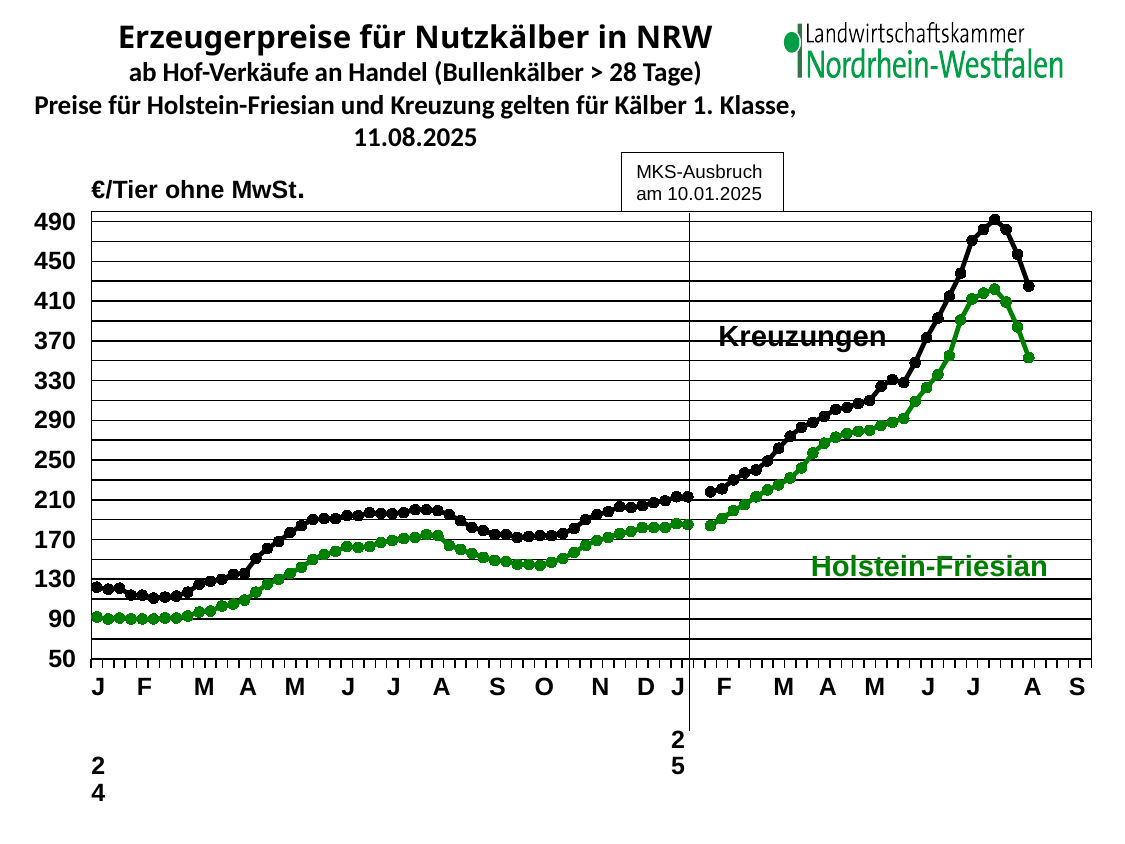
What unit is given for the vertical axis? €/Tier ohne MwSt. In which year does the Kreuzungen line reach its highest value? 2025 What kind of chart is shown on the slide? line chart Is the Holstein-Friesian value in January 2024 greater or less than 130? less Is the highest value of the Holstein-Friesian line greater or less than 370? greater Is the Kreuzungen value in January 2024 greater or less than 170? less Which series has the higher values throughout the chart, Kreuzungen or Holstein-Friesian? Kreuzungen Do the Kreuzungen prices rise or fall between January 2025 and July 2025? rise Do the Holstein-Friesian prices rise or fall between August 2024 and October 2024? fall How many series are plotted in the chart? 2 What is the title of the chart? Erzeugerpreise für Nutzkälber in NRW